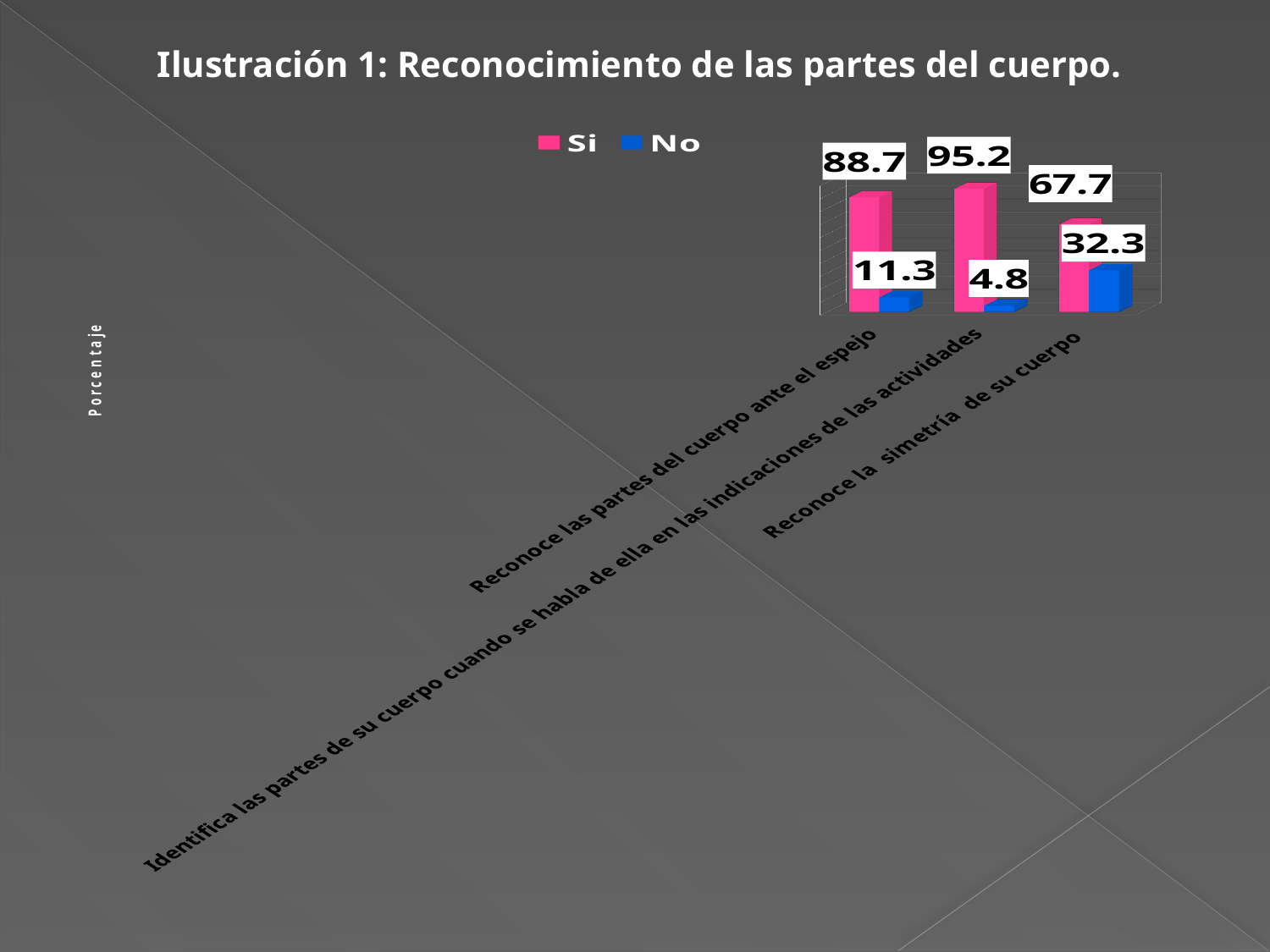
What is the 'Si' value for 'Reconoce las partes del cuerpo ante el espejo'? 88.7 What kind of chart is shown on the slide? Bar chart What is the difference between the 'Si' and 'No' values for 'Reconoce la simetría de su cuerpo'? 35.4 Which category has the highest 'Si' value? Identifica las partes de su cuerpo cuando se habla de ella en las indicaciones de las actividades How many categories are shown on the chart? 3 What is the 'No' value for 'Identifica las partes de su cuerpo cuando se habla de ella en las indicaciones de las actividades'? 4.8 Which category has the lowest 'No' value? Identifica las partes de su cuerpo cuando se habla de ella en las indicaciones de las actividades What is the title of the chart? Ilustración 1: Reconocimiento de las partes del cuerpo. What is the 'Si' value for 'Reconoce la simetría de su cuerpo'? 67.7 Which is larger: the 'No' value for 'Reconoce las partes del cuerpo ante el espejo' or the 'No' value for 'Reconoce la simetría de su cuerpo'? Reconoce la simetría de su cuerpo How many series does the legend list? 2 What is the 'No' value for 'Reconoce la simetría de su cuerpo'? 32.3